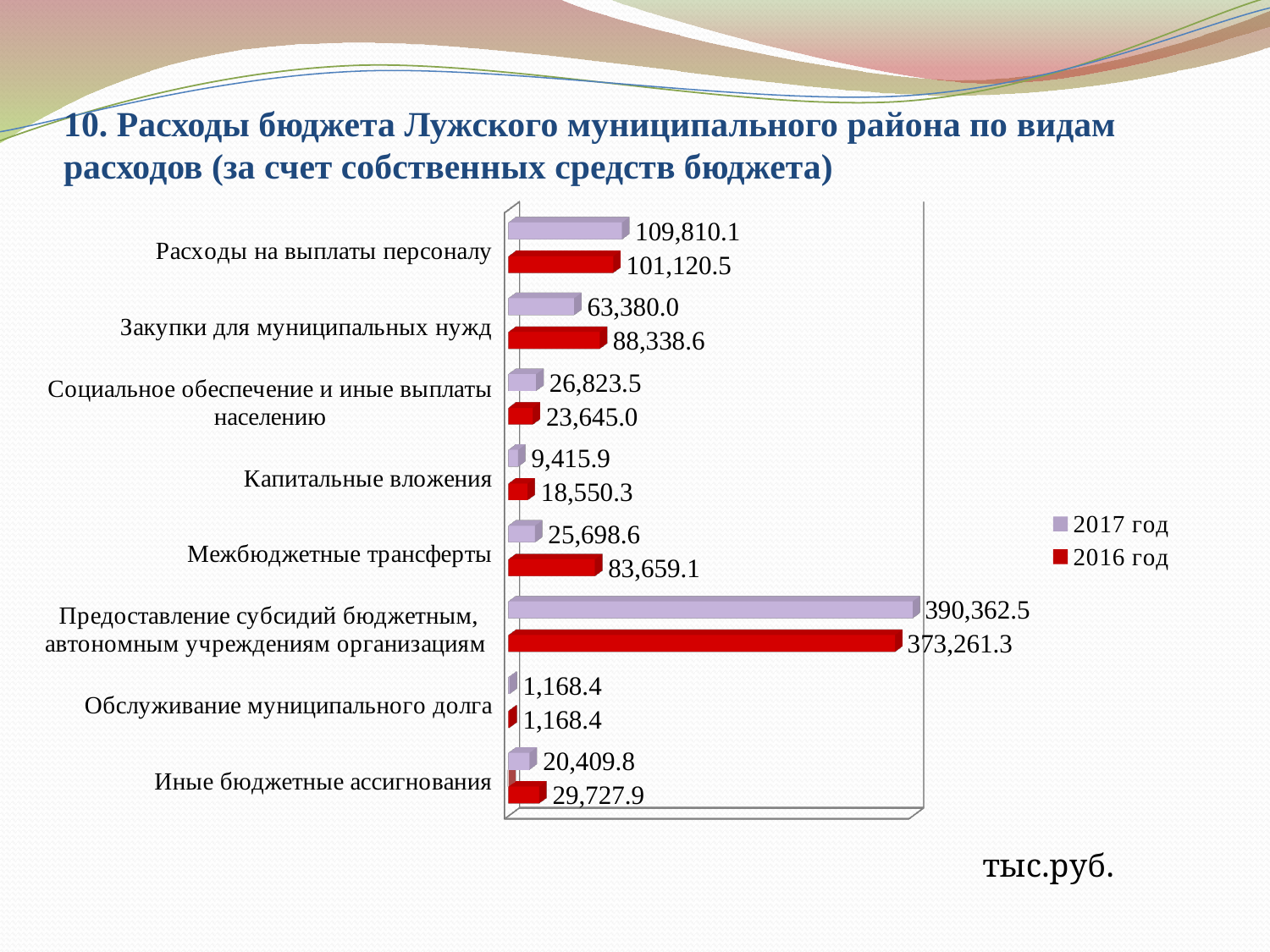
Which category has the lowest 2016 год value? Обслуживание муниципального долга Which category has the highest 2017 год value? Предоставление субсидий бюджетным, автономным учреждениям организациям How many series does the legend list? 2 What is the 2017 год value for Расходы на выплаты персоналу? 109,810.1 What is the 2016 год value for Иные бюджетные ассигнования? 29,727.9 What is the 2017 год value for Капитальные вложения? 9,415.9 What is the 2016 год value for Межбюджетные трансферты? 83,659.1 For Межбюджетные трансферты, which year has the larger value, 2017 год or 2016 год? 2016 год How many expense categories are shown in the chart? 8 What kind of chart is shown on the slide? Bar chart What is the difference between the 2016 год and 2017 год values for Закупки для муниципальных нужд? 24,958.6 What is the difference between the 2017 год and 2016 год values for Расходы на выплаты персоналу? 8,689.6